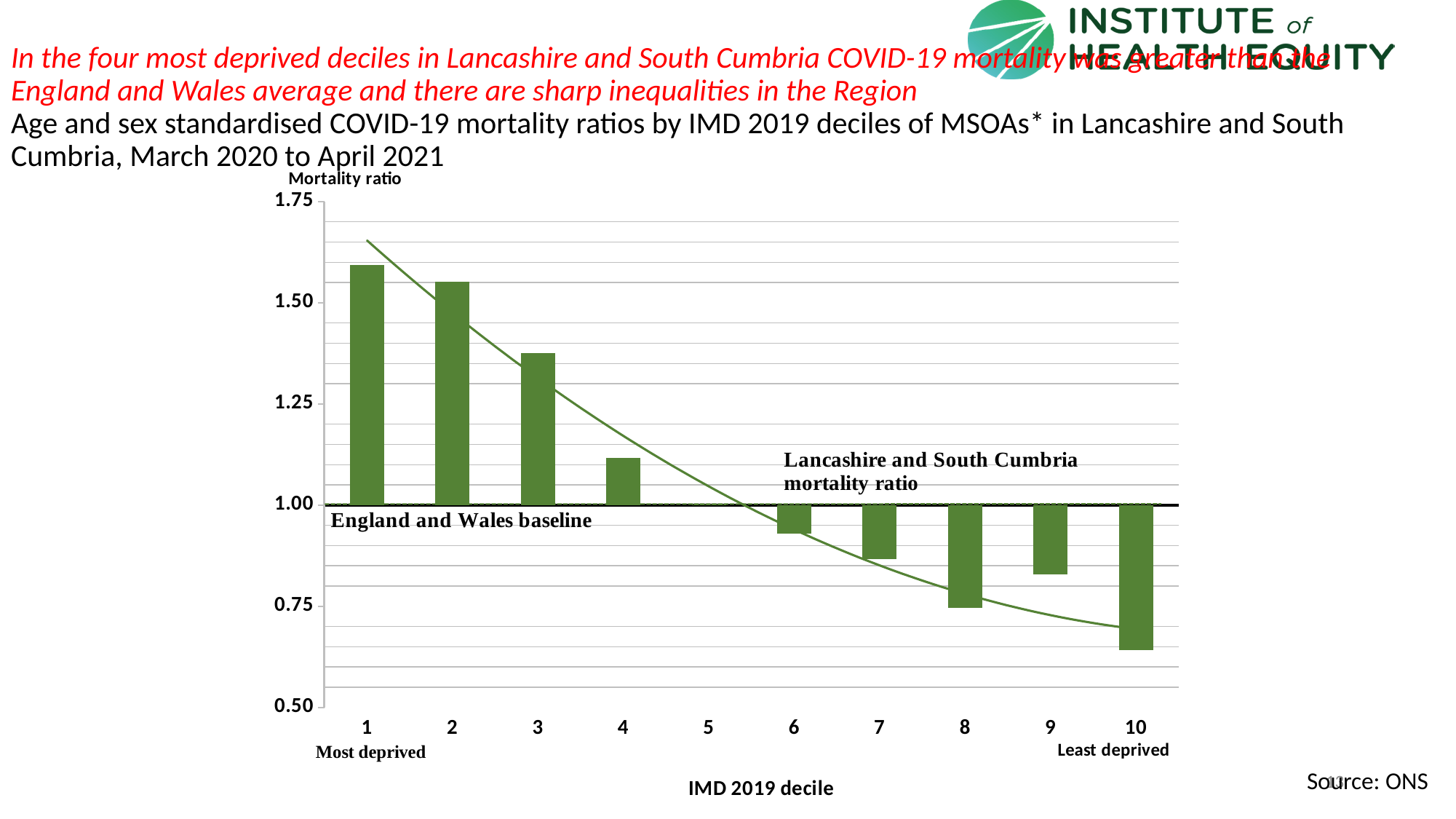
Which has the larger mortality ratio, decile 3 or decile 4? Decile 3 What kind of chart is shown on the slide? Bar chart Which IMD decile has the highest mortality ratio? 1 Which has the larger mortality ratio, decile 8 or decile 9? Decile 9 Which IMD decile has the lowest mortality ratio? 10 What is the label of the horizontal line at 1.00? England and Wales baseline Is the mortality ratio for decile 3 greater or less than 1.25? greater Do the mortality ratios generally rise or fall from decile 1 to decile 10? Fall Is the mortality ratio for decile 7 greater or less than 1.00? less Is the mortality ratio for decile 1 greater or less than 1.50? greater How many IMD 2019 deciles are shown on the x axis? 10